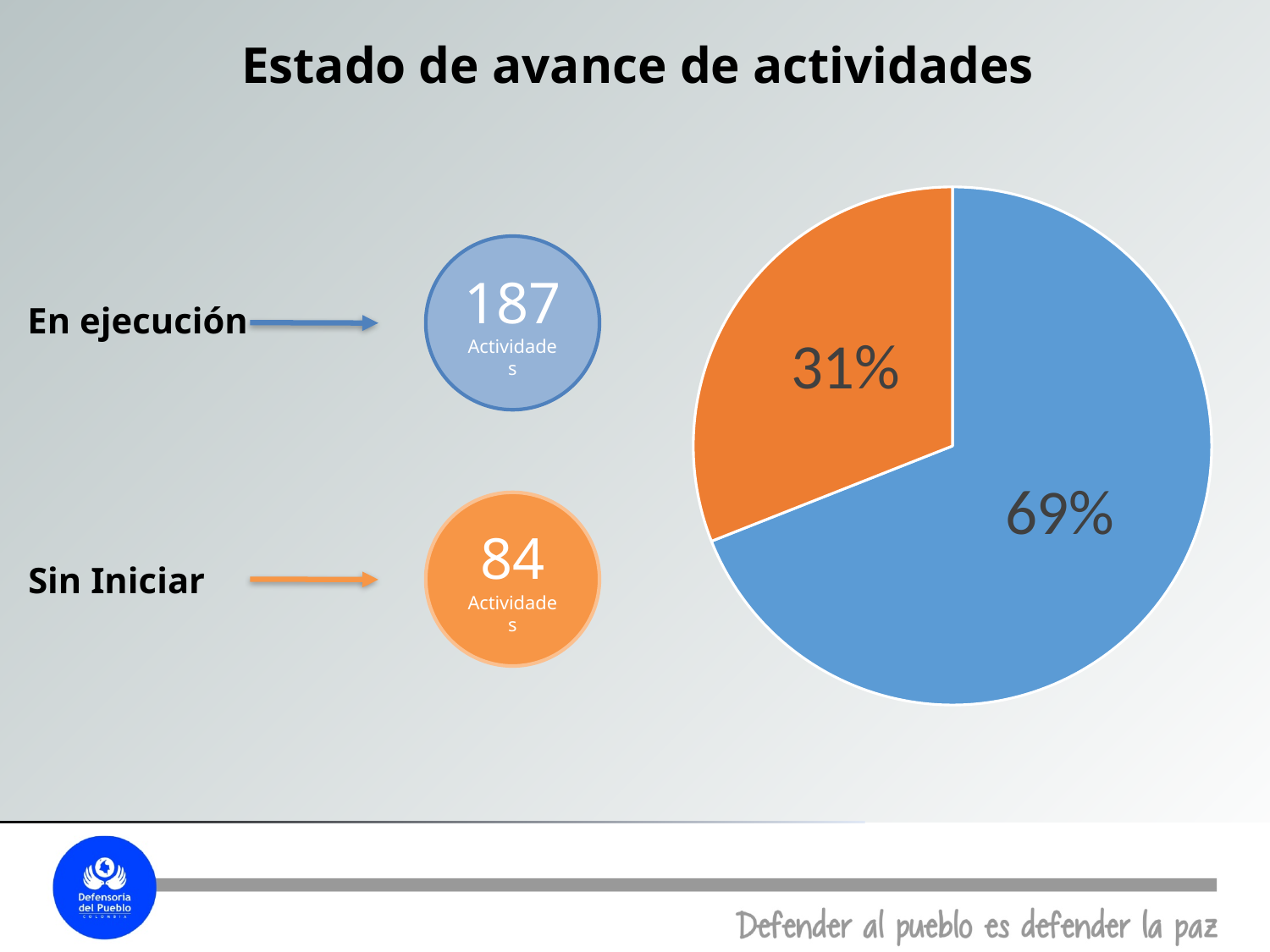
Is the blue slice of the pie chart larger or smaller than the orange slice? larger What percentage is shown on the blue slice of the pie chart? 69% How many slices does the pie chart have? 2 What is the difference in percentage points between the blue slice and the orange slice of the pie chart? 38 What kind of chart is shown on the slide? pie chart How many activities are shown in the blue circle labelled 'En ejecución'? 187 What percentage is shown on the orange slice of the pie chart? 31% Which slice of the pie chart is the smallest? the orange slice (31%) Which slice of the pie chart is the largest? the blue slice (69%) What is the title of the slide containing the pie chart? Estado de avance de actividades How many activities are shown in the orange circle labelled 'Sin Iniciar'? 84 What share of the pie does the orange slice represent? 31%